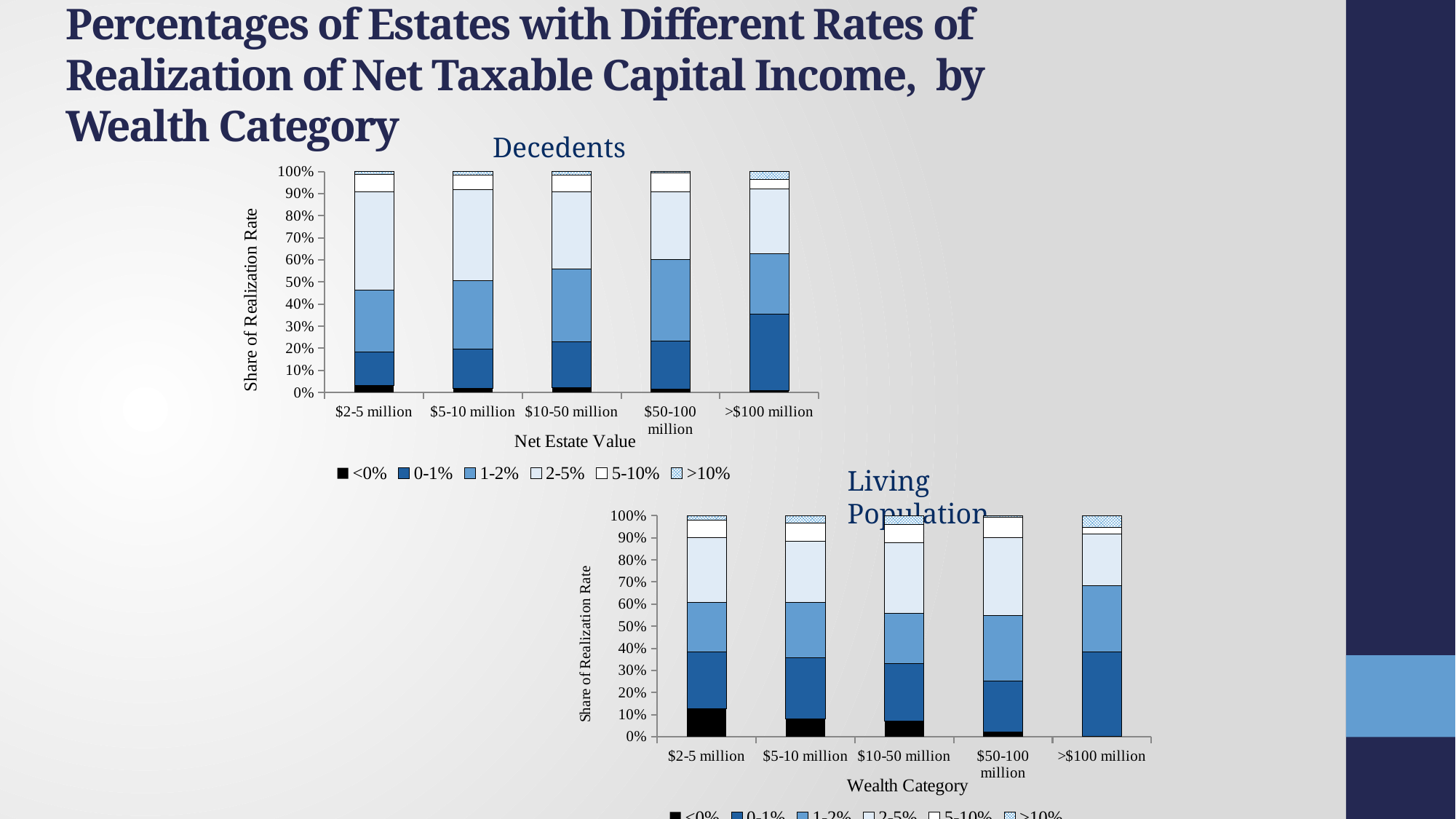
In the Living Population chart, does the <0% segment rise or fall as wealth category increases from $2-5 million to >$100 million? fall In the Decedents chart, is the 0-1% share for >$100 million greater or less than 30%? greater How many wealth categories are shown on the x axis of the Living Population chart? 5 How many series does the legend of the Decedents chart list? 6 What is the x-axis title of the Decedents chart? Net Estate Value What kind of chart is the Decedents chart? stacked bar chart In the Living Population chart, is the <0% share for $2-5 million greater or less than 10%? greater In the Living Population chart, is the <0% share for >$100 million greater or less than 10%? less In the Living Population chart, which category has the largest <0% segment? $2-5 million In the Decedents chart, does the 0-1% segment rise or fall as net estate value increases from $2-5 million to >$100 million? rise In the Living Population chart, which is larger: the <0% share for $2-5 million or for $50-100 million? $2-5 million In the Decedents chart, which category has the largest 0-1% segment? >$100 million